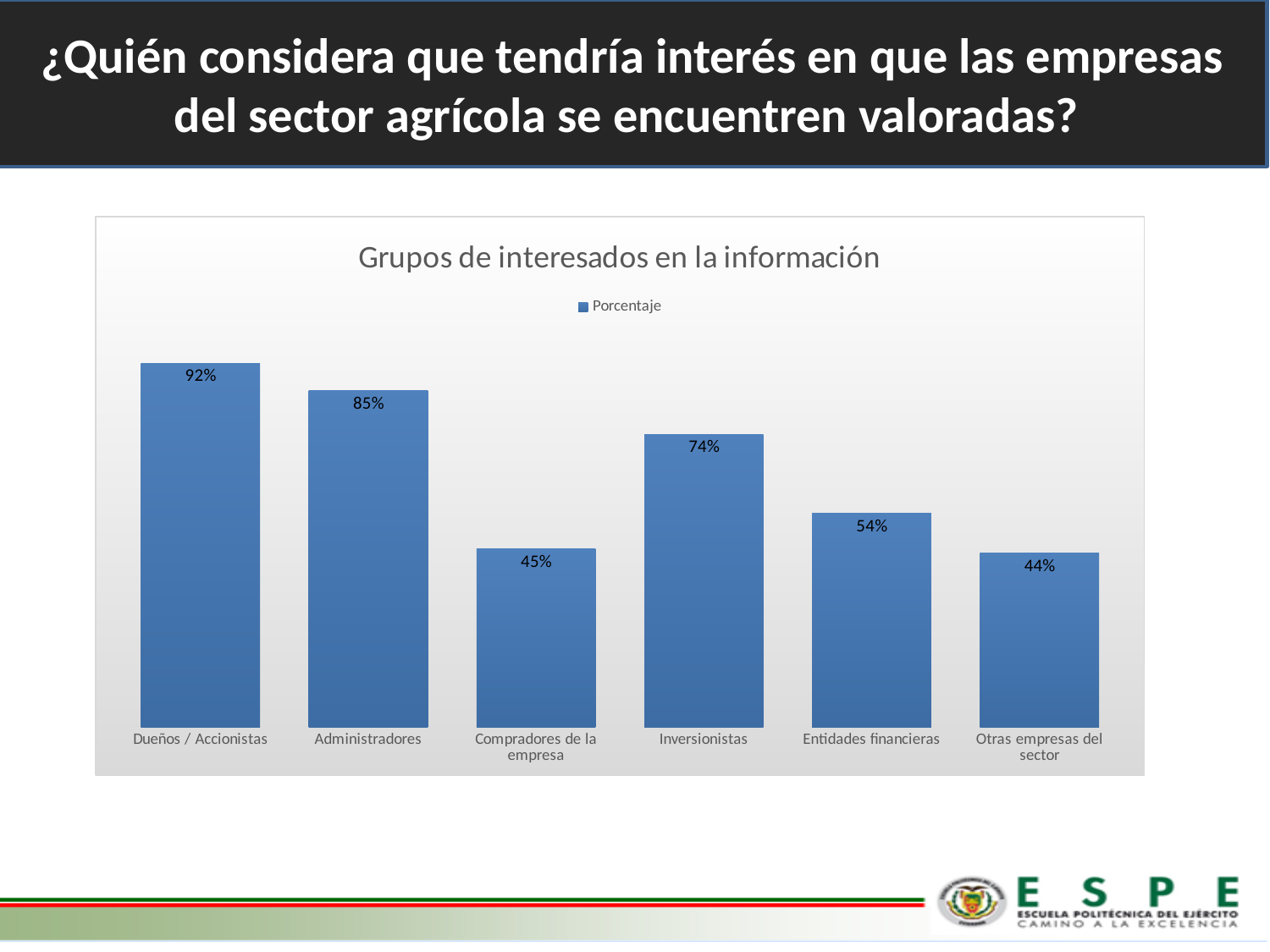
What is the name of the series in the legend? Porcentaje What is the value for Entidades financieras? 54% What is the value for Dueños / Accionistas? 92% How many categories are shown in the chart? 6 Which category has the highest value? Dueños / Accionistas What is the value for Inversionistas? 74% What is the difference between the values for Administradores and Compradores de la empresa? 40% What is the title of the chart? Grupos de interesados en la información Which is larger, the value for Inversionistas or the value for Entidades financieras? Inversionistas How many series does the legend list? 1 Which category has the lowest value? Otras empresas del sector What kind of chart is shown? Bar chart